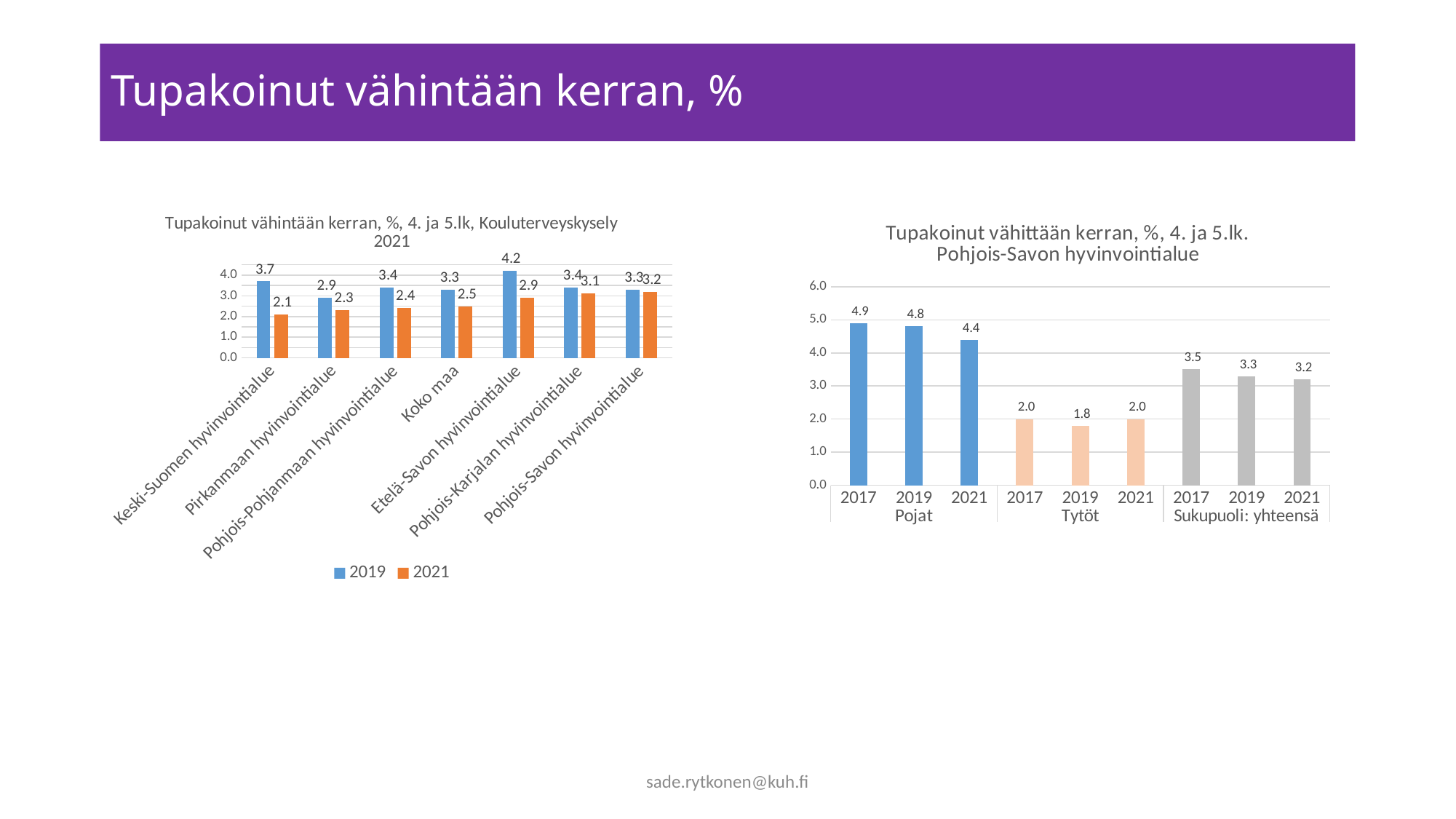
In the left chart, what is the 2021 value for Keski-Suomen hyvinvointialue? 2.1 In the right chart (Pohjois-Savon hyvinvointialue), what is the value for Tytöt in 2019? 1.8 In the left chart, what is the difference between the 2019 and 2021 values for Koko maa? 0.8 In the right chart (Pohjois-Savon hyvinvointialue), what is the value for Pojat in 2017? 4.9 In the right chart (Pohjois-Savon hyvinvointialue), which is larger: Pojat 2021 or Sukupuoli: yhteensä 2017? Pojat 2021 In the left chart, what is the 2019 value for Etelä-Savon hyvinvointialue? 4.2 In the left chart, how many regions (categories) are shown? 7 In the left chart, which region has the lowest 2021 value? Keski-Suomen hyvinvointialue In the left chart, which region has the highest 2019 value? Etelä-Savon hyvinvointialue What type of chart is the right chart (Pohjois-Savon hyvinvointialue)? bar chart In the left chart, how many series does the legend list? 2 In the right chart (Pohjois-Savon hyvinvointialue), do the Pojat values rise or fall from 2017 to 2021? fall